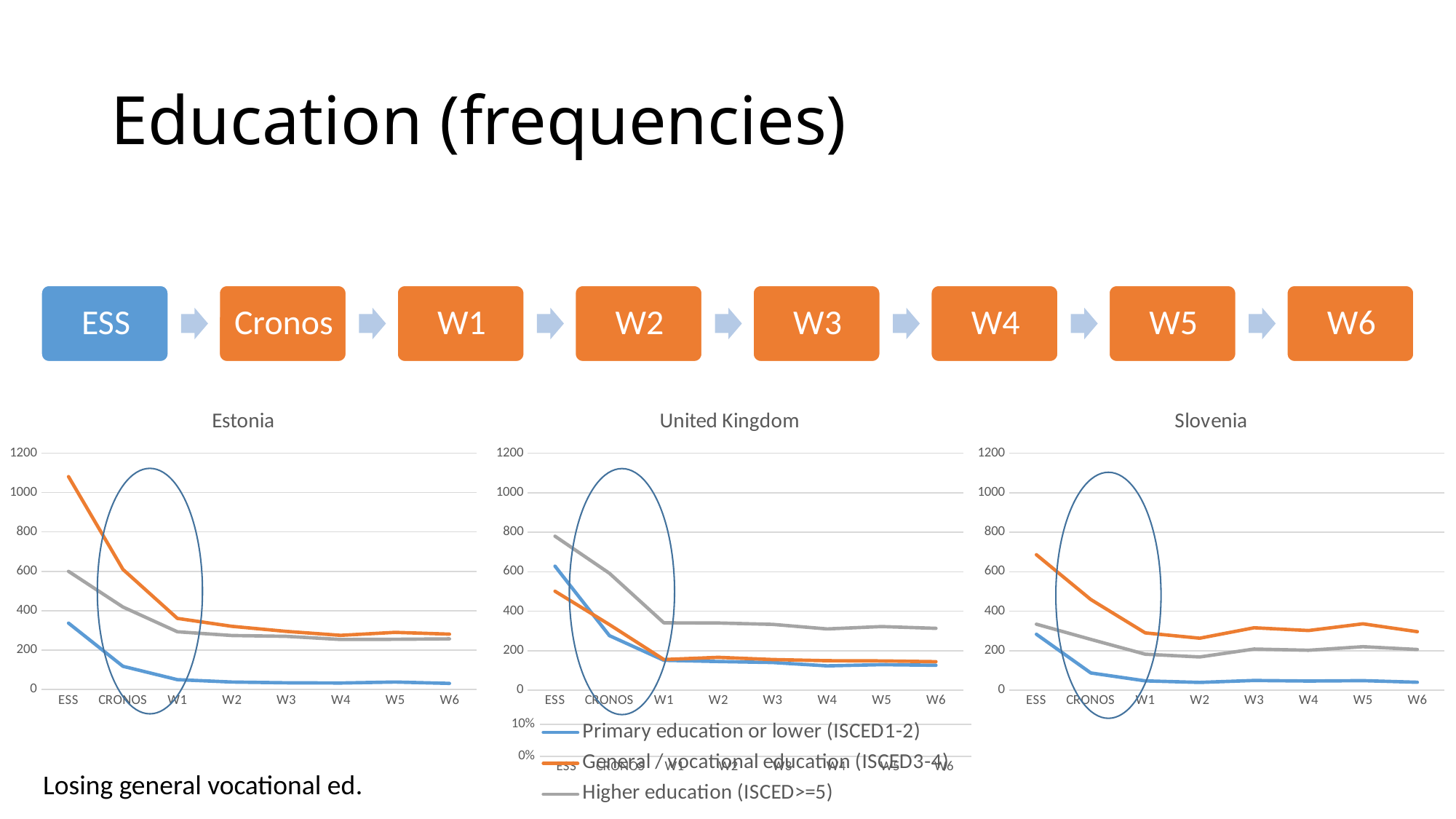
How many points are plotted along the x axis of the Slovenia chart? 8 In the Estonia chart, which series has the highest value at ESS? General / vocational education (ISCED3-4) In the Estonia chart, does the Primary education or lower series rise or fall from ESS to W1? fall What is the title of the middle chart on the slide? United Kingdom In the Slovenia chart, is the value for General / vocational education at ESS greater or less than 600? greater In the United Kingdom chart, which series has the highest value at ESS? Higher education (ISCED>=5) In the Slovenia chart, which is larger at ESS: General / vocational education or Higher education? General / vocational education (ISCED3-4) How many series does the legend list for the charts? 3 In the Estonia chart, which series has the lowest value at ESS? Primary education or lower (ISCED1-2) In the United Kingdom chart, is the value for Higher education at W1 greater or less than 400? less In the Estonia chart, is the value for General / vocational education at ESS greater or less than 1000? greater What kind of chart is the Estonia chart? line chart